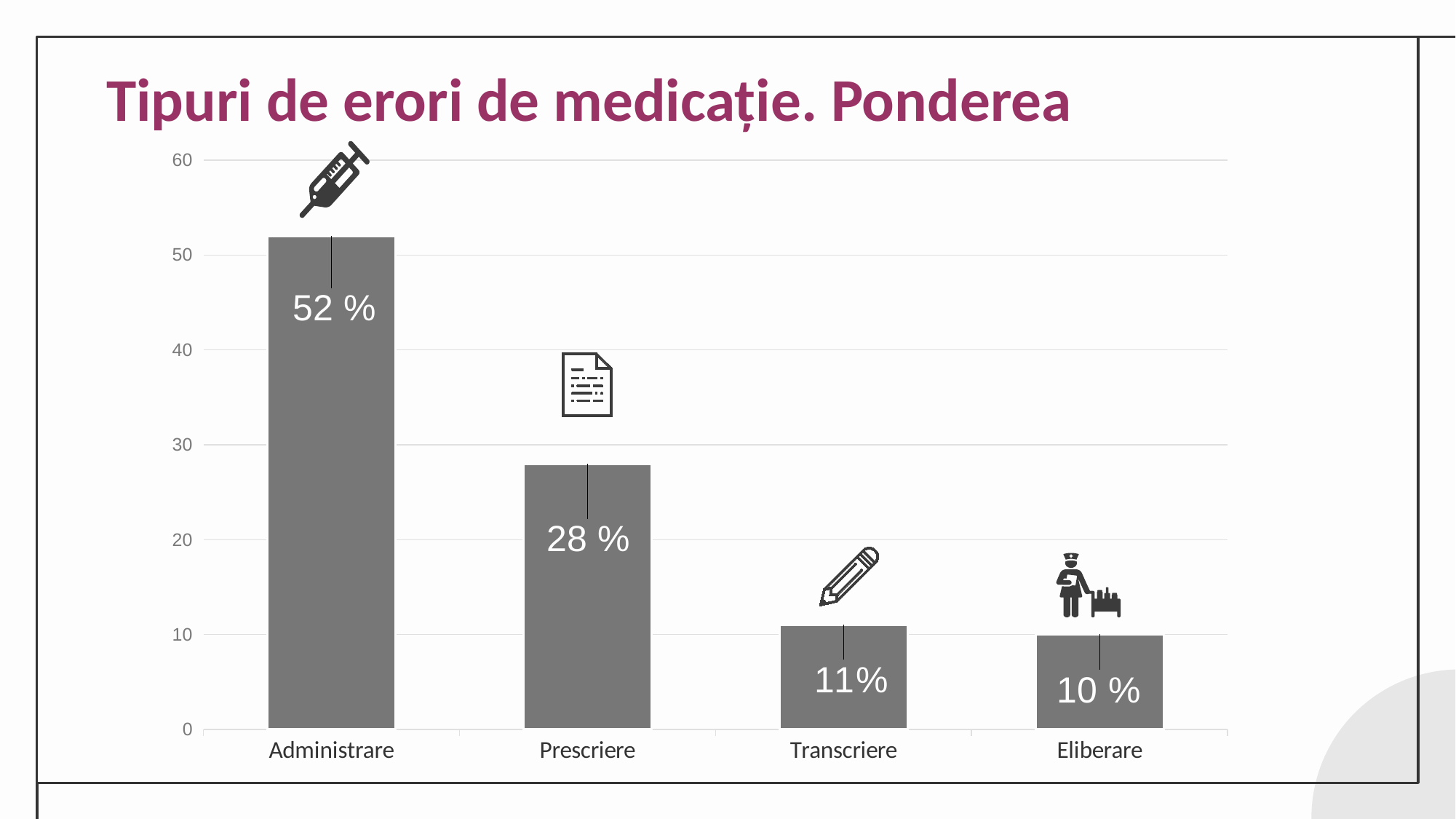
What is the value for Prescriere? 28 % Which category has the lowest value? Eliberare How many categories are shown on the x axis? 4 What is the value for Eliberare? 10 % What is the difference between the values for Administrare and Prescriere? 24 % What is the value for Transcriere? 11% What is the title of the slide? Tipuri de erori de medicație. Ponderea Is the value for Prescriere greater or less than 30? less Which category has the highest value? Administrare What is the value for Administrare? 52 % What kind of chart is shown on the slide? bar chart Which is larger, the value for Prescriere or the value for Transcriere? Prescriere